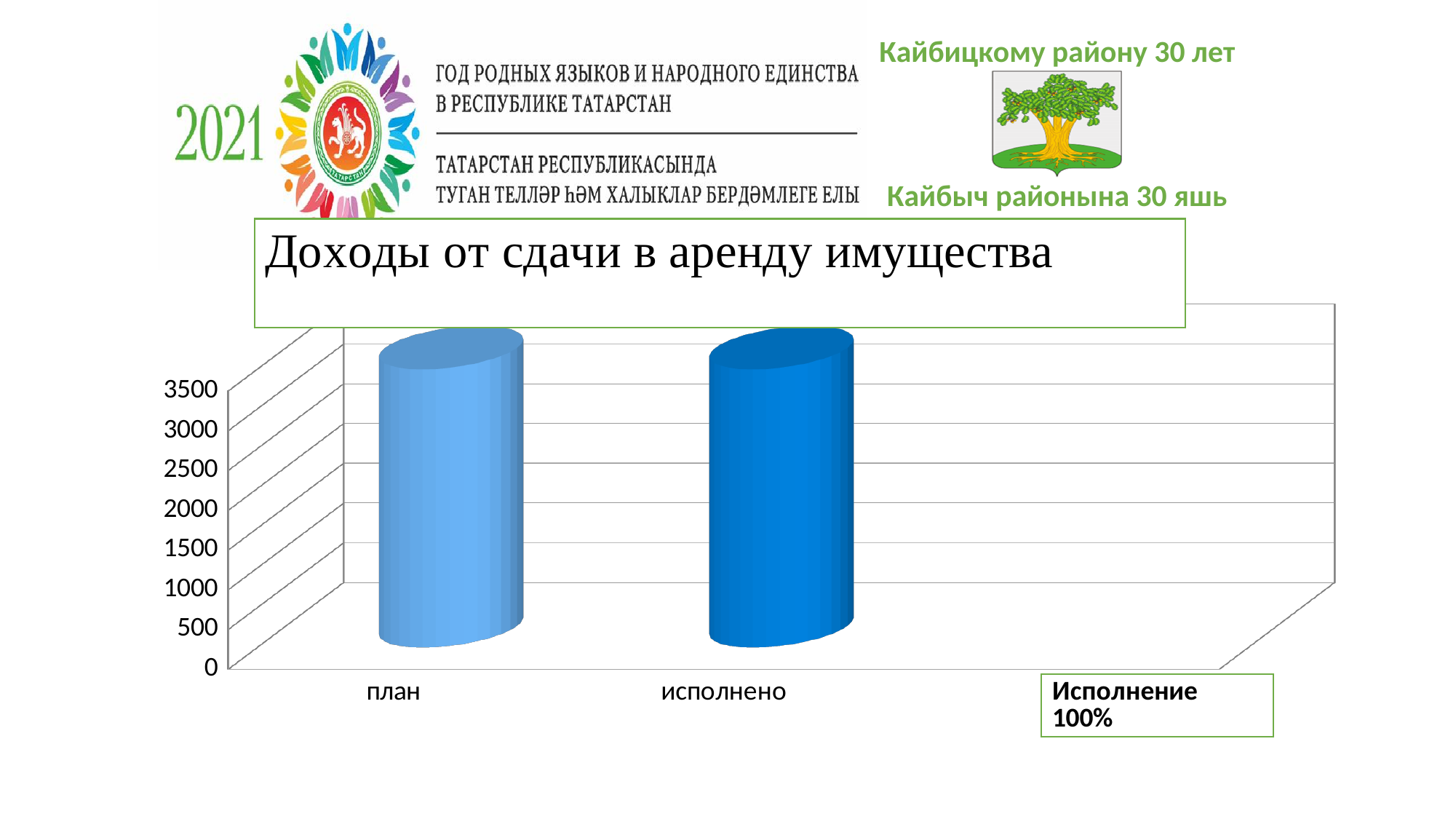
How many categories are plotted on the x axis of the chart? 2 What is the title of the chart? Доходы от сдачи в аренду имущества Is the value for план greater or less than 2000? greater Is the value for исполнено greater or less than 1500? greater Is the value for план greater or less than 3000? greater What are the two category labels on the x axis of the chart? план, исполнено What kind of chart is shown on the slide? bar chart What is the highest tick value shown on the vertical axis of the chart? 3500